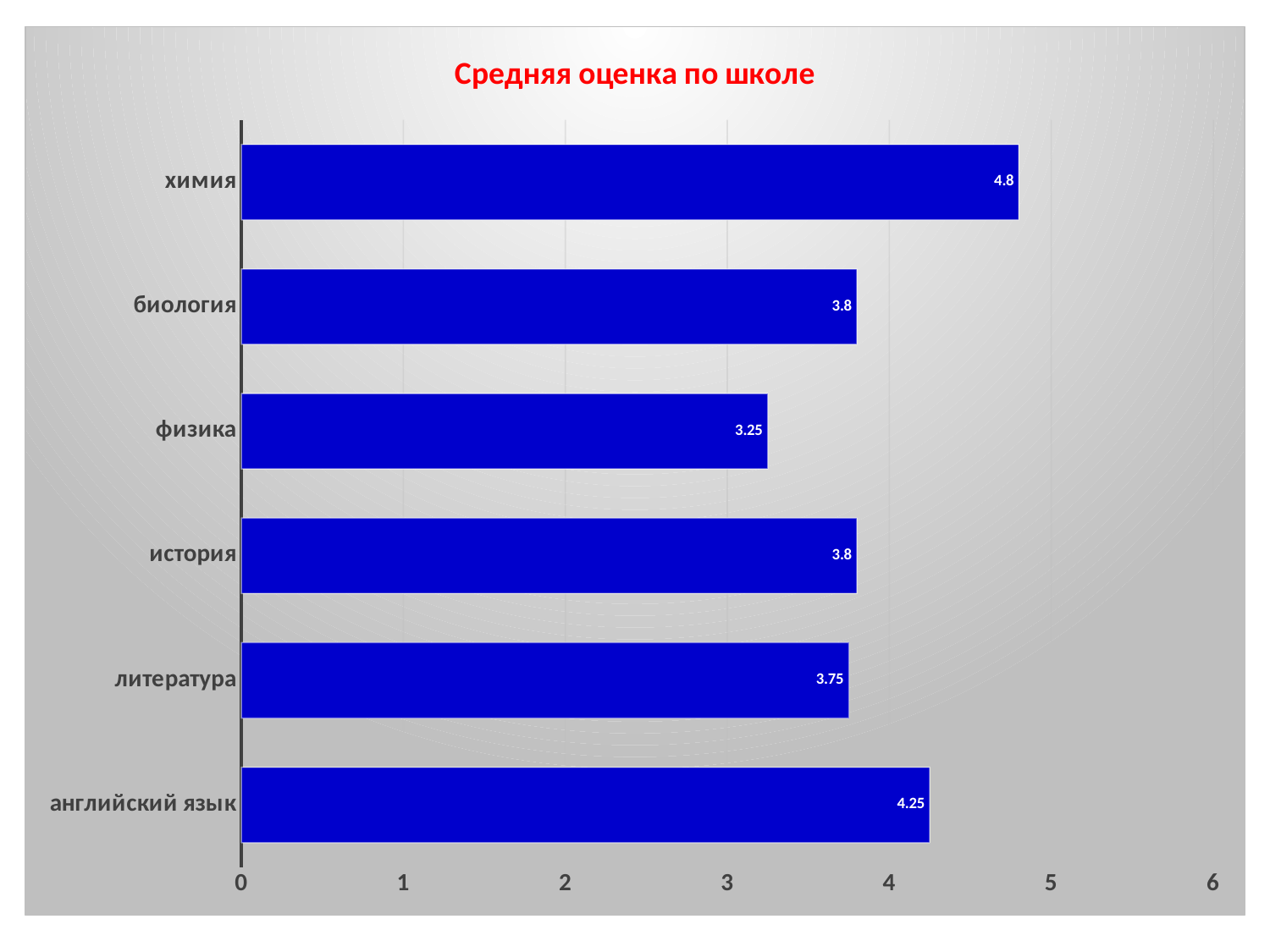
What is the value for физика? 3.25 How many categories are shown in the chart? 6 Which is larger, the value for английский язык or the value for история? английский язык What is the difference between the values for английский язык and биология? 0.45 What is the value for химия? 4.8 Which category has the lowest value? физика What is the value for английский язык? 4.25 What kind of chart is this? bar chart Is the value for биология greater or less than 3? greater What is the value for литература? 3.75 Which category has the highest value? химия What is the difference between the values for химия and физика? 1.55